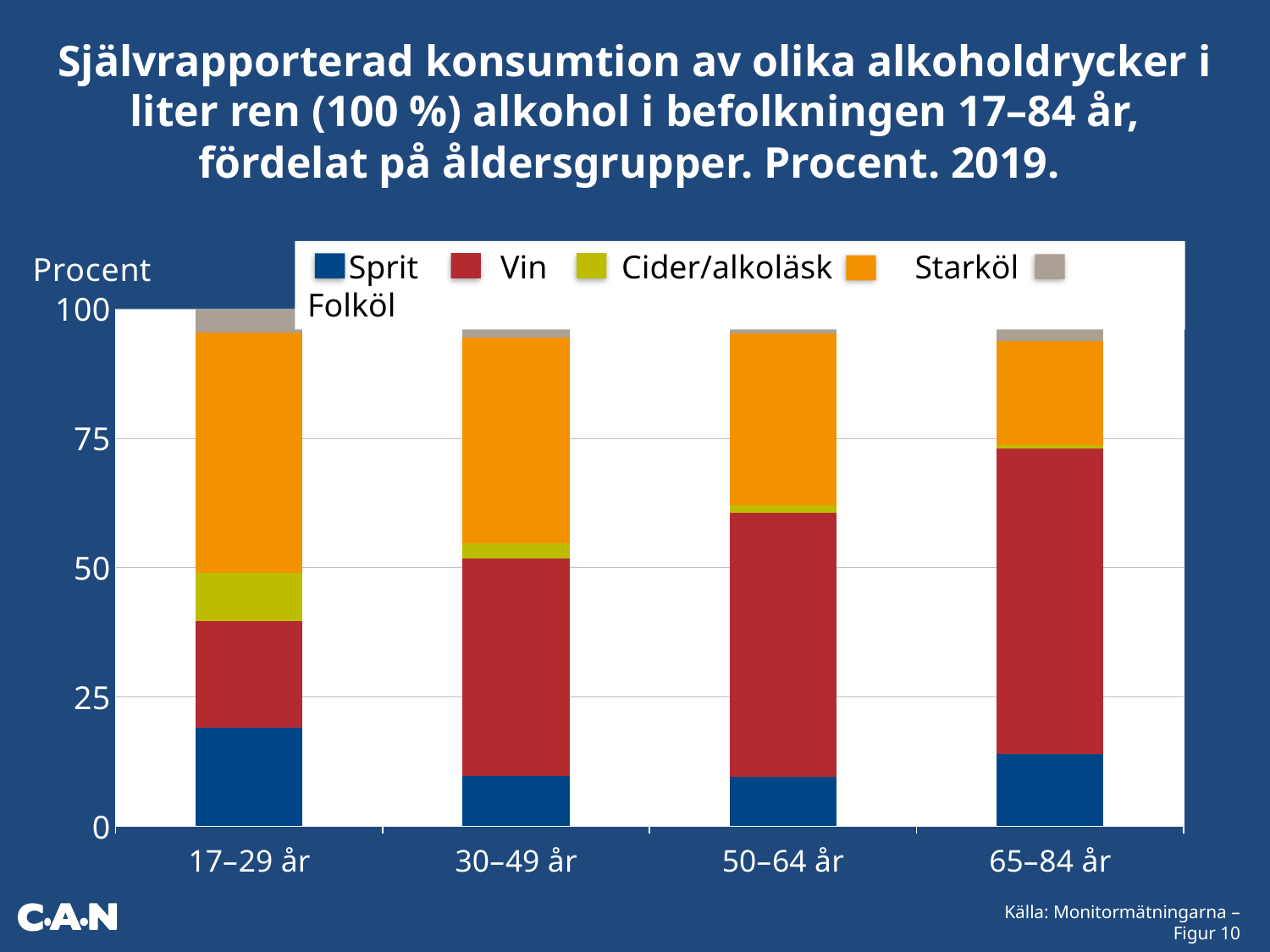
What kind of chart is shown on the slide? stacked bar chart Which series are listed in the legend? Sprit, Vin, Cider/alkoläsk, Starköl, Folköl Does the Vin share rise or fall from the youngest to the oldest age group? rise Which age group has the largest Starköl share? 17–29 år Is the Vin share for 65–84 år greater or less than 50? greater Is the Cider/alkoläsk share for 17–29 år greater or less than 25? less Is the Sprit share for 17–29 år greater or less than 25? less Is the Sprit share larger for 17–29 år or for 30–49 år? 17–29 år How many age groups are shown on the x axis? 4 How many series does the legend list? 5 Which age group has the largest Vin share? 65–84 år What is the label on the y axis? Procent